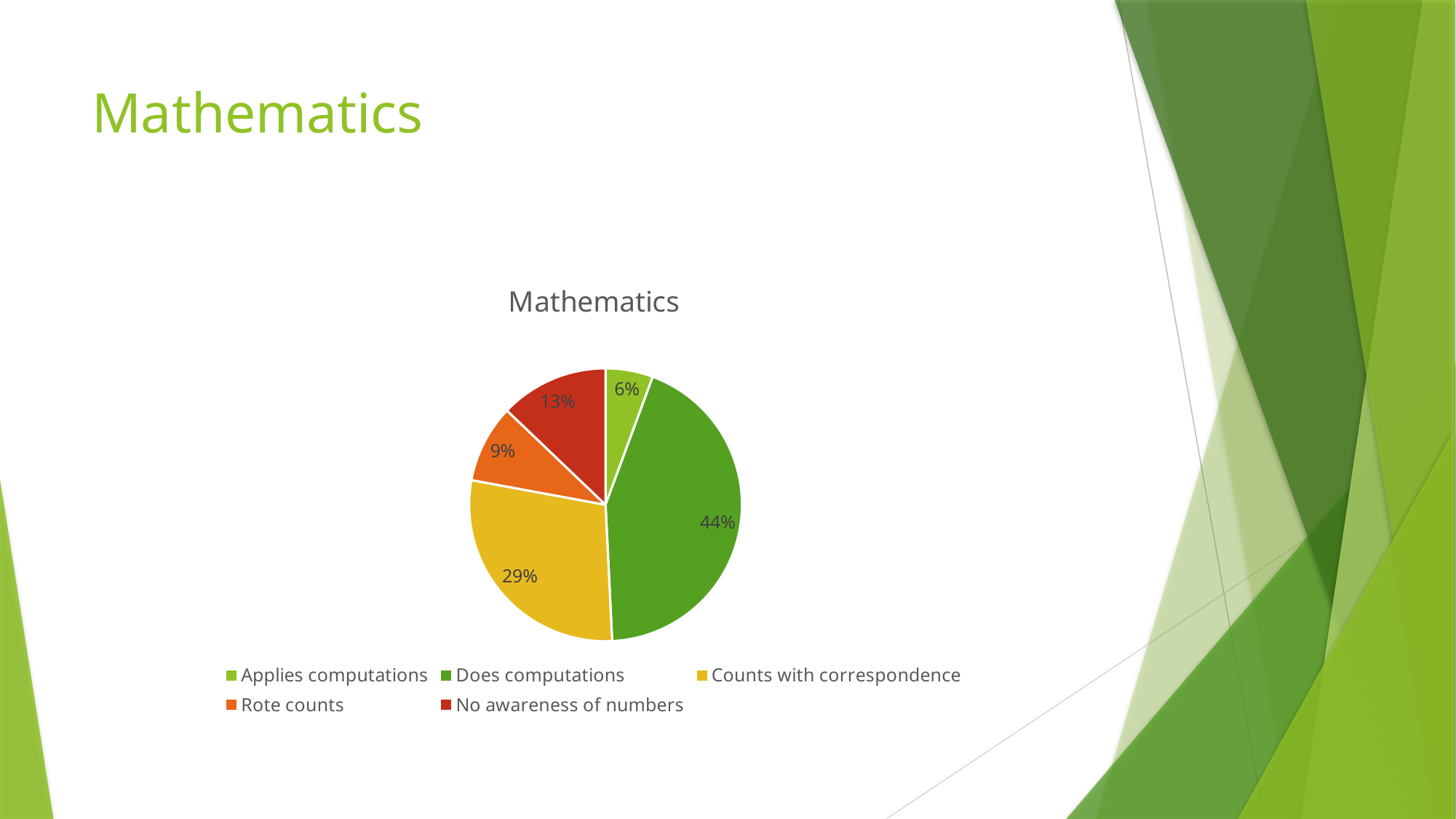
What percentage of the pie is 'Does computations'? 44% Which is larger, the share for 'No awareness of numbers' or the share for 'Rote counts'? No awareness of numbers What is the difference in percentage points between 'Does computations' and 'Counts with correspondence'? 15 What is the title of the chart? Mathematics What percentage of the pie is 'No awareness of numbers'? 13% Which category has the largest share of the pie? Does computations What type of chart is shown on the slide? pie chart How many categories does the legend list? 5 Which category has the smallest share of the pie? Applies computations What percentage of the pie is 'Rote counts'? 9% What percentage of the pie is 'Counts with correspondence'? 29% What percentage of the pie is 'Applies computations'? 6%